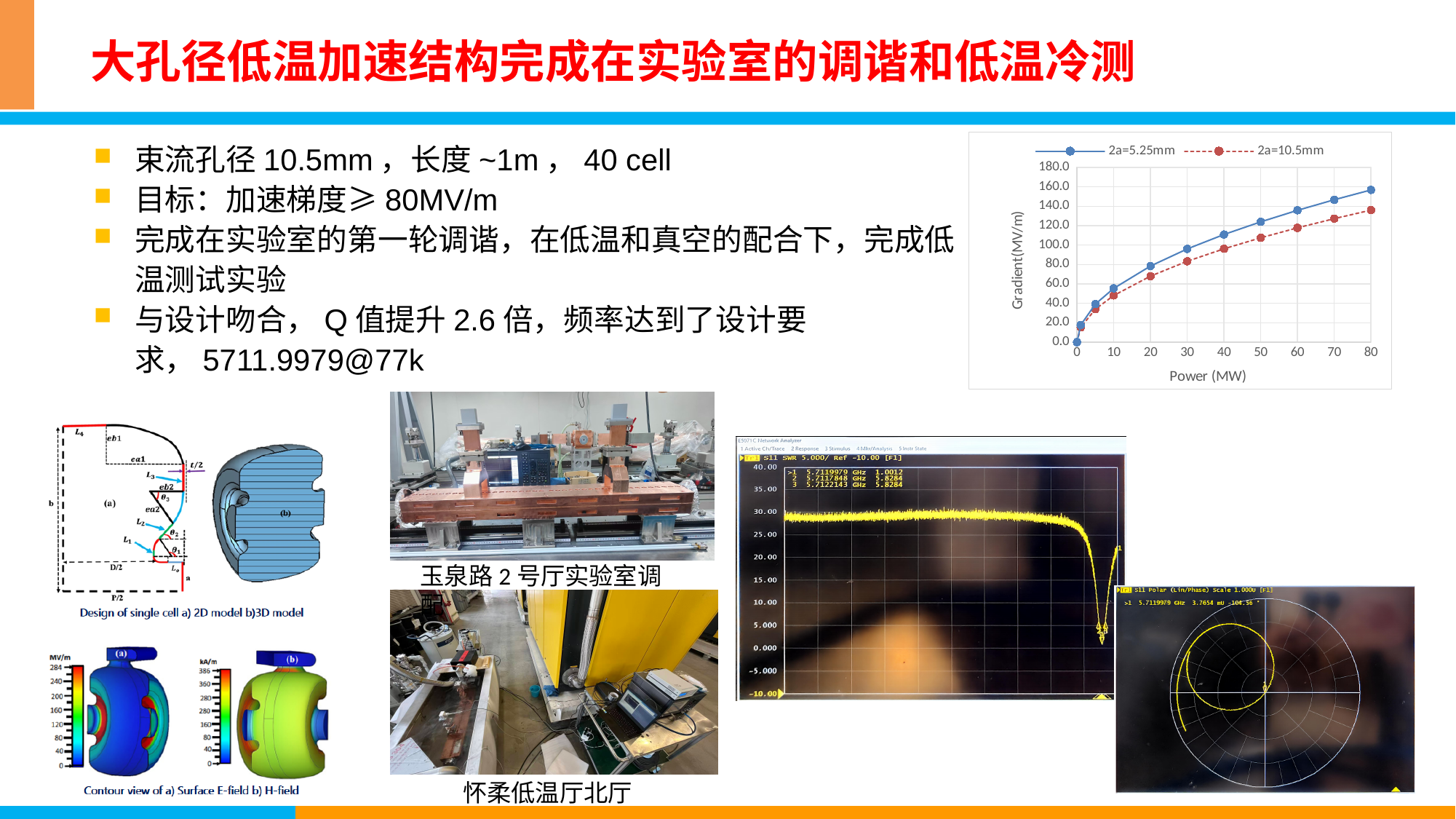
What kind of chart is the Gradient vs Power chart at the top right of the slide? line chart In the Gradient vs Power line chart at the top right, how many series does the legend list? 2 In the Gradient vs Power chart at the top right, which series has the higher gradient at 80 MW, 2a=5.25mm or 2a=10.5mm? 2a=5.25mm In the Gradient vs Power chart at the top right, does the gradient rise or fall as power increases? rise In the Gradient vs Power chart at the top right, is the gradient for 2a=5.25mm at 40 MW greater or less than 100? greater In the Gradient vs Power chart at the top right, what are the two series named in the legend? 2a=5.25mm and 2a=10.5mm In the Gradient vs Power chart at the top right, is the gradient for 2a=10.5mm at 20 MW greater or less than 80? less In the Gradient vs Power chart at the top right, is the gradient for 2a=5.25mm at 80 MW greater or less than 140? greater In the Gradient vs Power chart at the top right, what is the label of the y axis? Gradient(MV/m) In the Gradient vs Power chart at the top right, which series reaches the lowest gradient at 60 MW? 2a=10.5mm